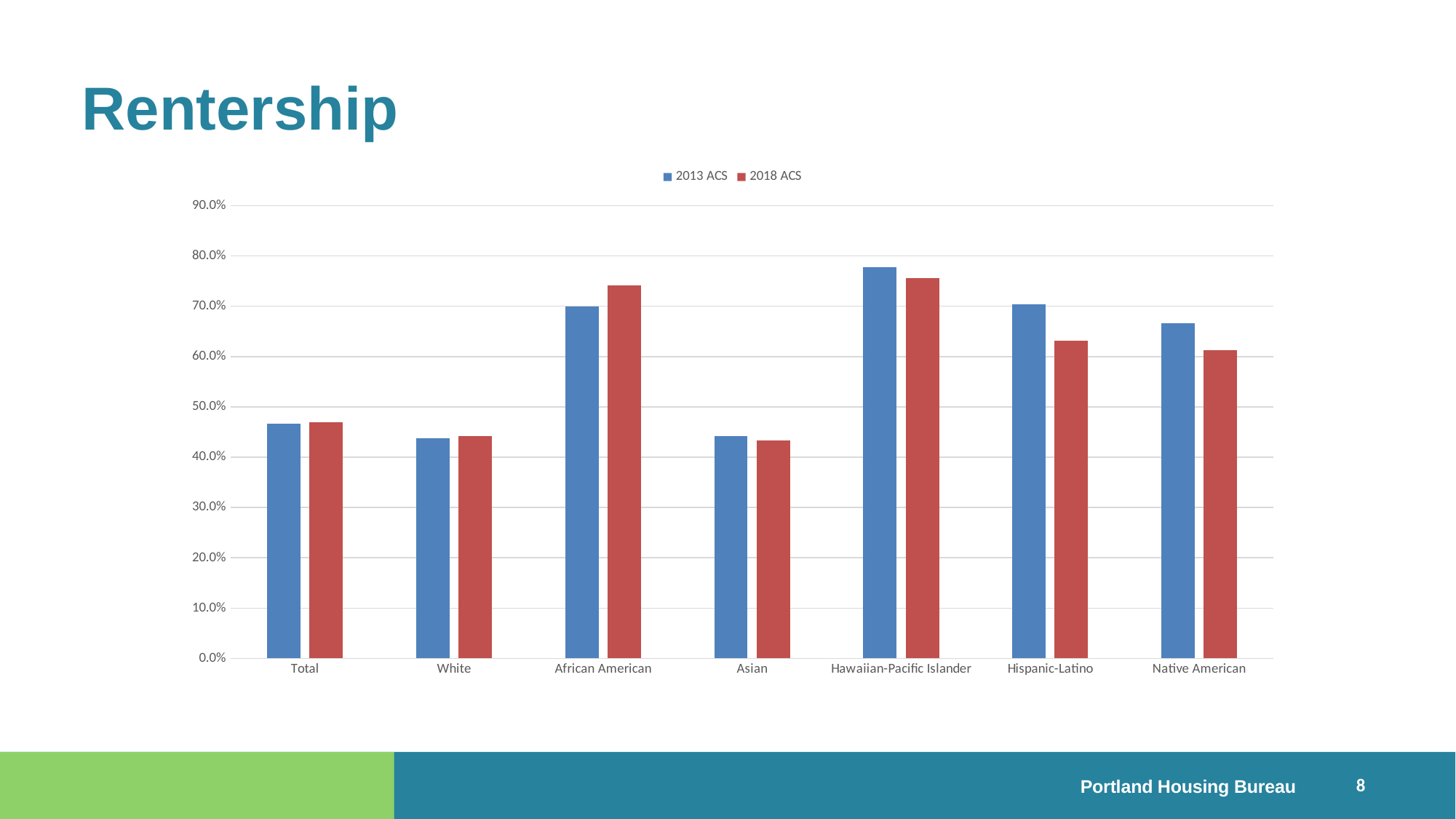
Is the 2018 ACS value for African American greater or less than 70.0%? greater Is the 2013 ACS value for Hawaiian-Pacific Islander greater or less than 70.0%? greater Is the 2018 ACS value for Asian greater or less than 50.0%? less Which category has the highest 2013 ACS value? Hawaiian-Pacific Islander How many series does the legend list? 2 How many categories are shown on the x axis? 7 For Native American, which is larger: the 2013 ACS value or the 2018 ACS value? 2013 ACS What kind of chart is shown on the slide? bar chart For African American, which is larger: the 2013 ACS value or the 2018 ACS value? 2018 ACS What is the title of the slide containing the chart? Rentership For Hispanic-Latino, which is larger: the 2013 ACS value or the 2018 ACS value? 2013 ACS